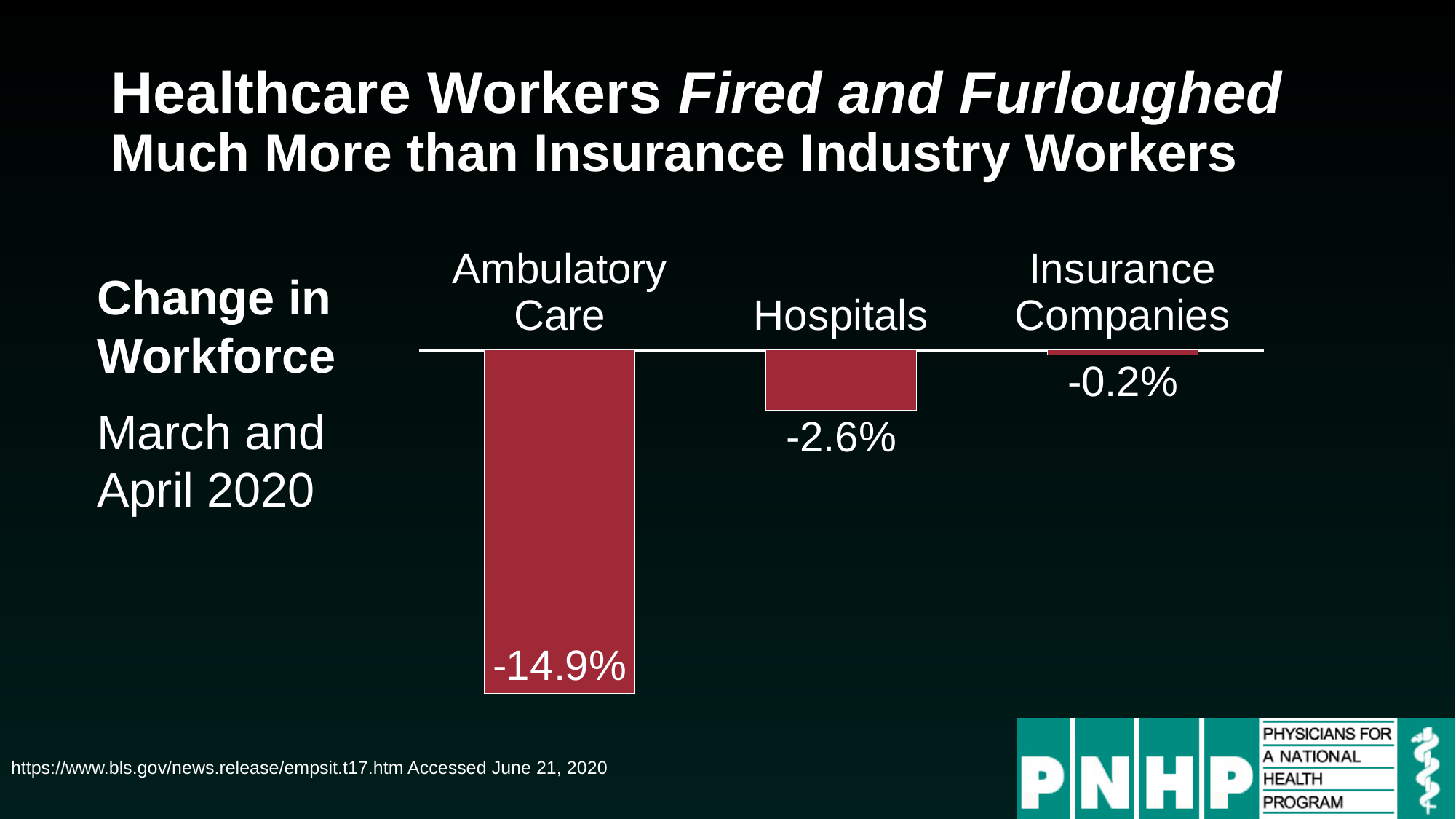
What is the difference in percentage points between the Ambulatory Care and Hospitals values? 12.3 percentage points What colour are the bars in the chart? Red What kind of chart is shown on the slide? Bar chart Which category shows the smallest workforce decline? Insurance Companies What is the change in workforce for Insurance Companies? -0.2% How many categories are shown in the chart? 3 Which category shows the largest workforce decline? Ambulatory Care Which had a larger workforce decline, Hospitals or Insurance Companies? Hospitals What time period does the chart cover, according to the label on the left? March and April 2020 What is the change in workforce for Hospitals? -2.6% What is the difference in percentage points between the Hospitals and Insurance Companies values? 2.4 percentage points What is the change in workforce for Ambulatory Care? -14.9%